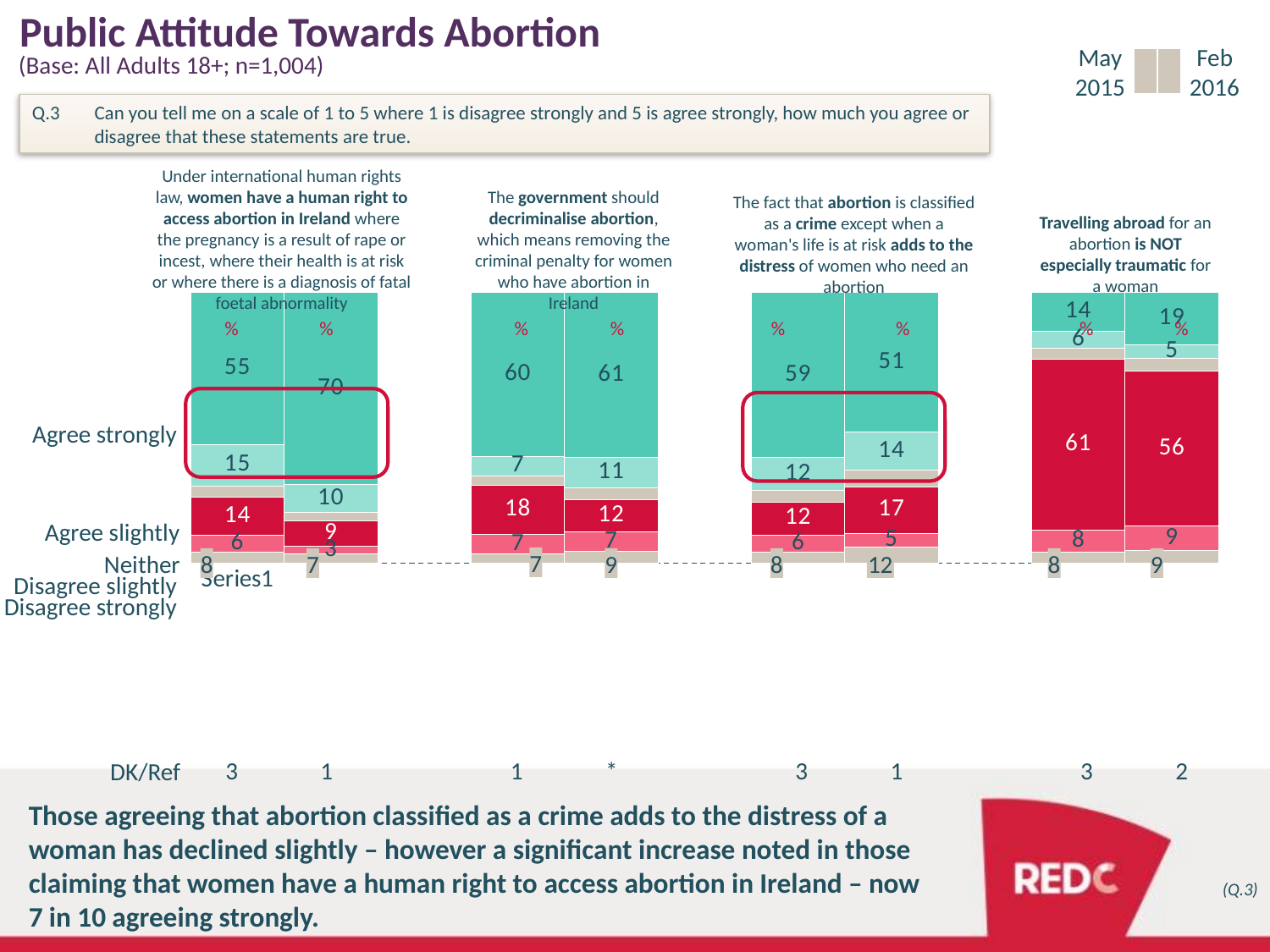
In the chart about women having a human right to access abortion in Ireland, what percentage agreed strongly in Feb 2016? 70 How many time periods does the legend at the top right of the slide compare? 2 In the chart about abortion being classified as a crime adding to distress, by how many points did the 'agree strongly' share fall from May 2015 to Feb 2016? 8 In the chart about abortion being classified as a crime adding to distress, what percentage agreed strongly in May 2015? 59 In the chart about the government decriminalising abortion, what percentage agreed strongly in Feb 2016? 61 What is the DK/Ref figure for May 2015 in the chart about abortion being classified as a crime adding to distress? 3 In the chart about travelling abroad for an abortion not being especially traumatic, what percentage agreed strongly in Feb 2016? 19 How many separate statement charts are shown on the slide? 4 In the chart about women having a human right to access abortion in Ireland, by how many points did the 'agree strongly' share increase from May 2015 to Feb 2016? 15 What type of chart is used to show the responses on this slide? Stacked bar chart In the chart about the government decriminalising abortion, which period had the higher 'agree strongly' share, May 2015 or Feb 2016? Feb 2016 In the chart about women having a human right to access abortion in Ireland, what percentage agreed strongly in May 2015? 55